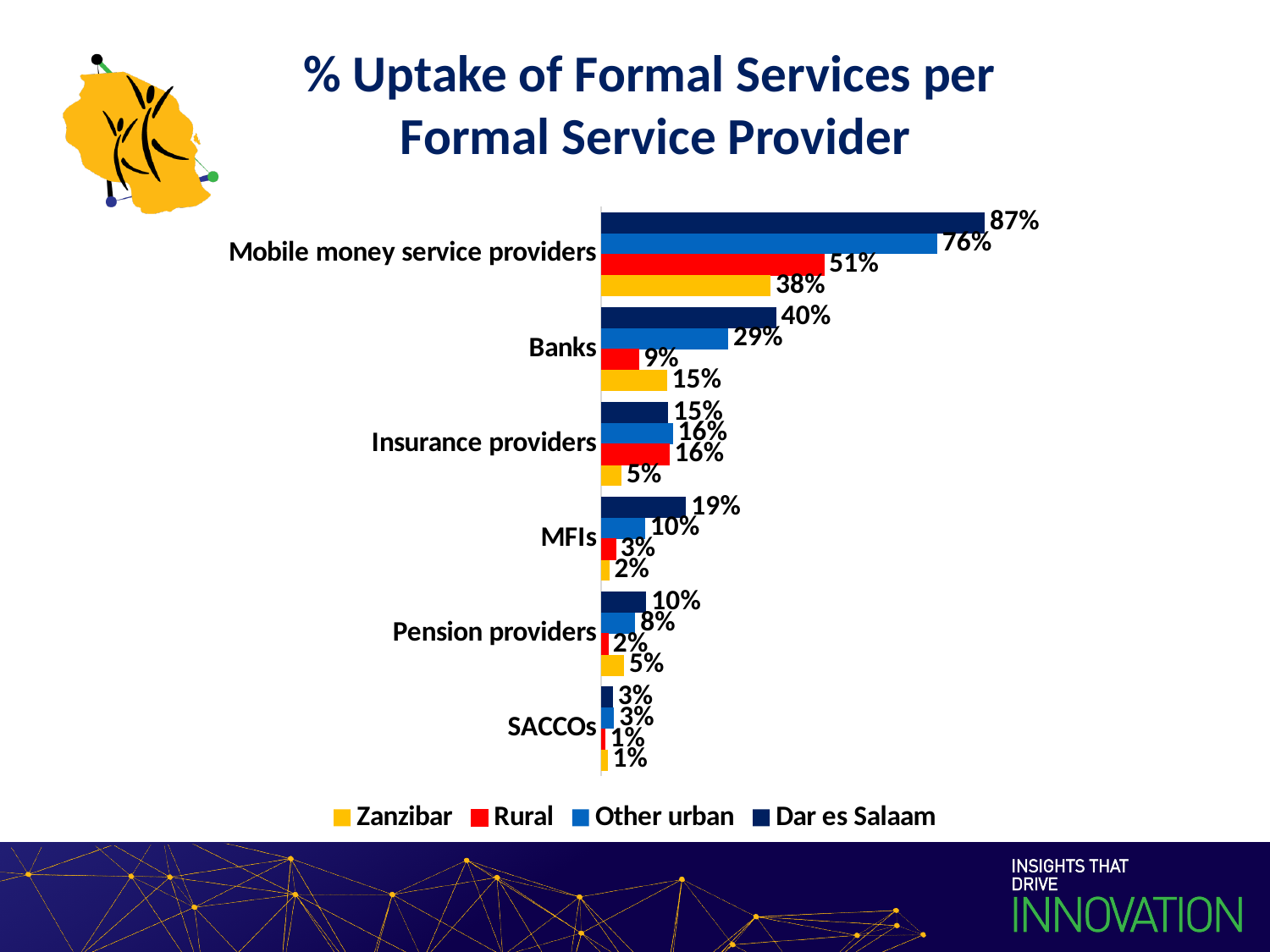
Which service provider has the highest Dar es Salaam value? Mobile money service providers How many service provider categories are shown on the chart? 6 What is the Dar es Salaam value for Mobile money service providers? 87% Which service provider has the lowest Other urban value? SACCOs What is the Other urban value for MFIs? 10% What kind of chart is shown on the slide? Bar chart What is the Rural value for Banks? 9% What is the Zanzibar value for Insurance providers? 5% Which colour represents the Rural series in the legend? Red How many series does the legend list? 4 For Banks, which is larger: the Zanzibar value or the Rural value? Zanzibar What is the difference between the Dar es Salaam and Zanzibar values for Mobile money service providers? 49%